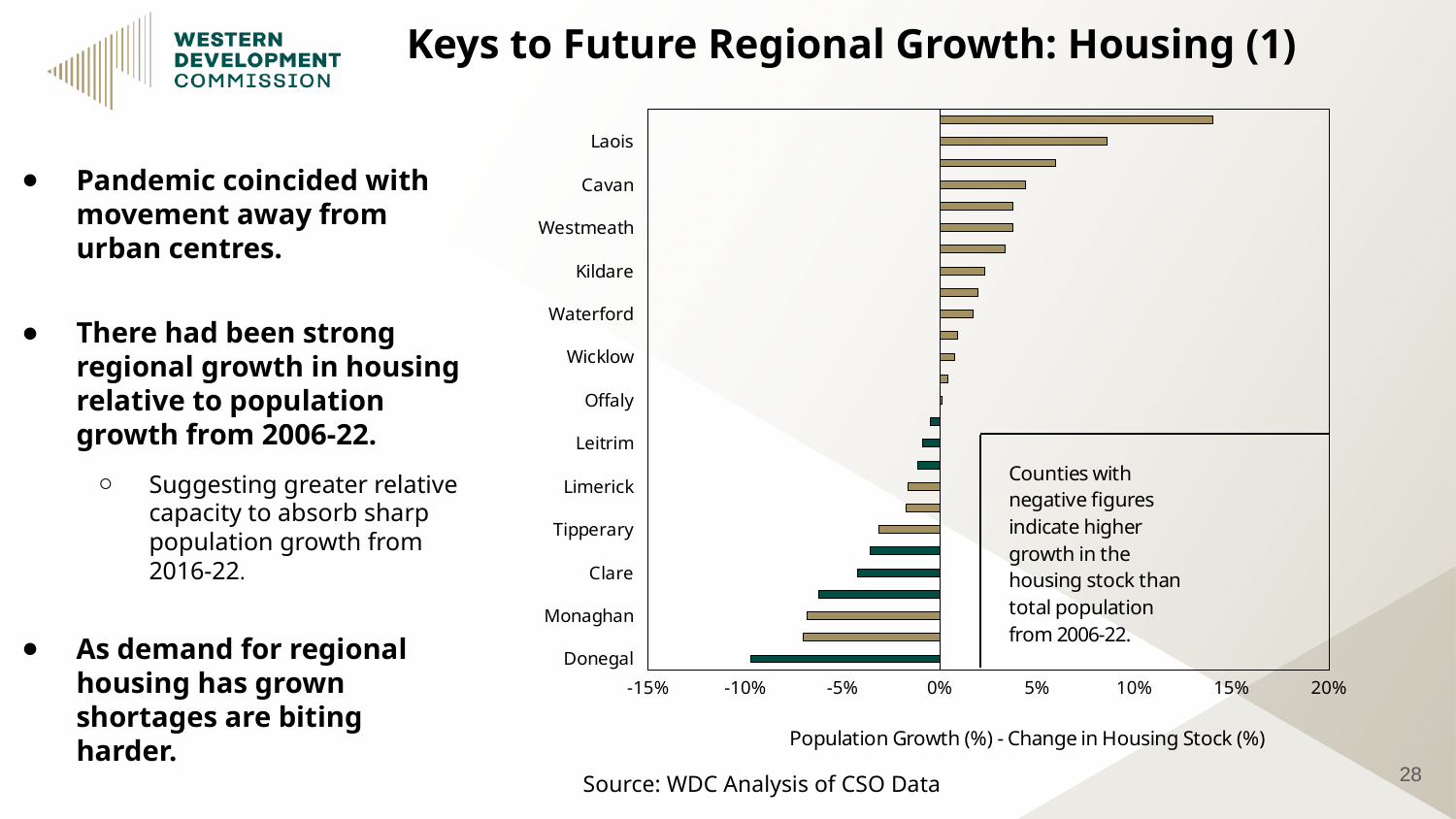
What is the title of the horizontal axis? Population Growth (%) - Change in Housing Stock (%) Which has the larger value, Laois or Cavan? Laois Is the value for Cavan greater or less than 5%? less Which has the larger value, Monaghan or Donegal? Monaghan Is the value for Laois greater or less than 5%? greater How many county labels are shown on the vertical axis? 13 Is the value for Clare greater or less than -5%? greater Among the counties labelled on the axis, which has the highest value? Laois What kind of chart is shown on the slide? Bar chart Among the counties labelled on the axis, which has the lowest value? Donegal